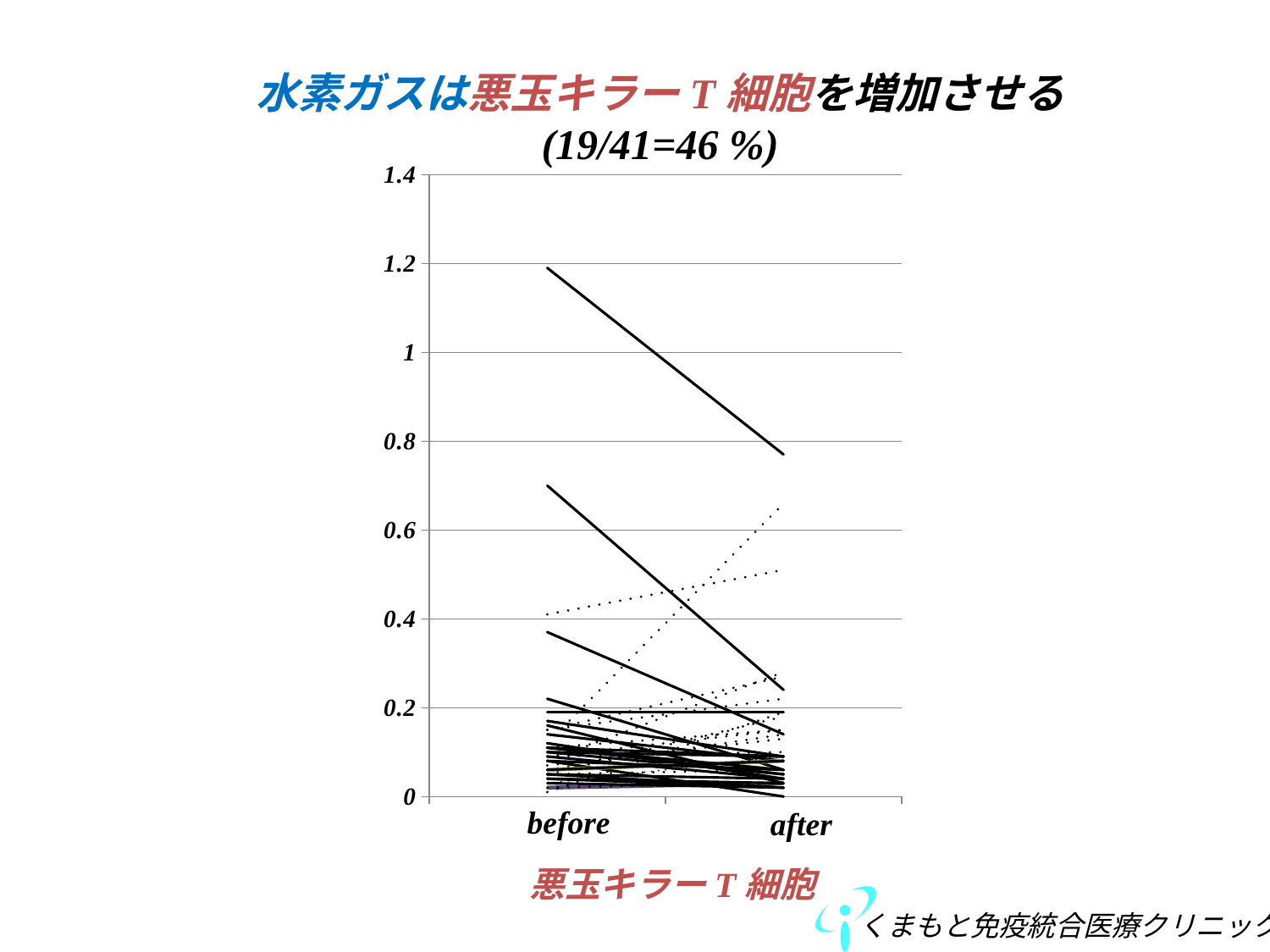
What kind of chart is shown on the slide? line chart How many categories are shown on the x axis of the chart? 2 Does the topmost line in the chart rise or fall from 'before' to 'after'? fall Is the 'before' value of the topmost line in the chart greater or less than 1? greater Is the 'before' value of the second-highest solid line in the chart greater or less than 0.6? greater What is the highest tick value shown on the y axis of the chart? 1.4 What are the two category labels on the x axis of the chart? before, after For the topmost line in the chart, which is larger, the 'before' value or the 'after' value? before Is the 'after' value of the second-highest solid line in the chart greater or less than 0.4? less What fraction and percentage are shown in parentheses in the chart title? 19/41=46 %